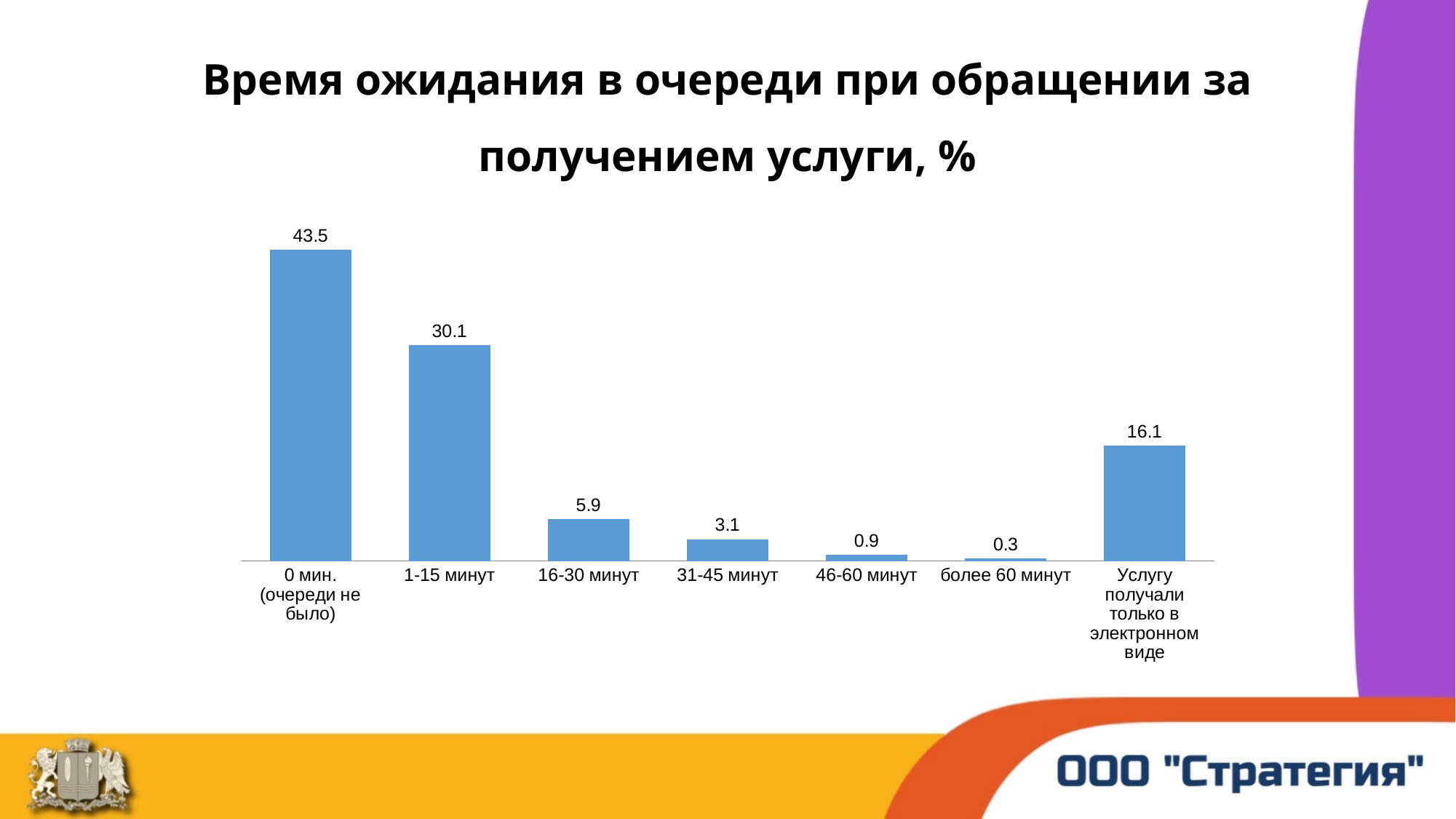
What is the value for the category "Услугу получали только в электронном виде"? 16.1 What is the value for the category "1-15 минут"? 30.1 What kind of chart is shown on the slide? Bar chart Which category has the highest value? 0 мин. (очереди не было) How many categories are shown on the chart? 7 Which is larger: the value for "16-30 минут" or the value for "Услугу получали только в электронном виде"? Услугу получали только в электронном виде What is the title of the chart? Время ожидания в очереди при обращении за получением услуги, % What is the value for the category "46-60 минут"? 0.9 What is the difference between the values for "16-30 минут" and "31-45 минут"? 2.8 Do the values rise or fall from "0 мин. (очереди не было)" to "более 60 минут"? Fall What is the difference between the values for "0 мин. (очереди не было)" and "1-15 минут"? 13.4 Which category has the lowest value? более 60 минут